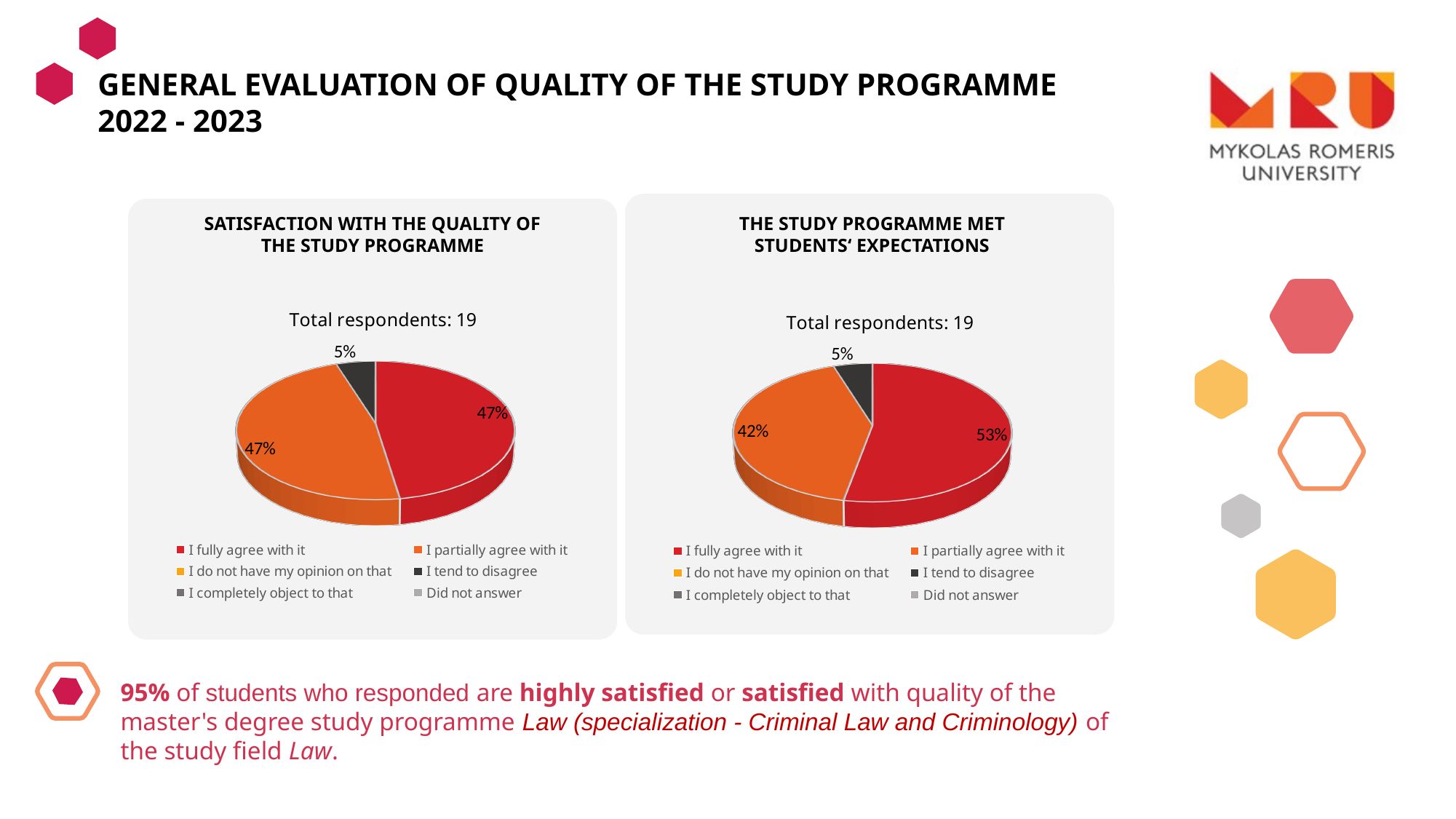
How many entries does the legend list in the chart titled 'The study programme met students' expectations'? 6 How many slices are visible in the pie in the chart titled 'Satisfaction with the quality of the study programme'? 3 In the chart titled 'The study programme met students' expectations', what share of respondents chose 'I fully agree with it'? 53% In the chart titled 'The study programme met students' expectations', which is larger: the share for 'I fully agree with it' or for 'I partially agree with it'? I fully agree with it In the chart titled 'Satisfaction with the quality of the study programme', what share of respondents chose 'I tend to disagree'? 5% In the chart titled 'The study programme met students' expectations', what share of respondents chose 'I partially agree with it'? 42% In the chart titled 'The study programme met students' expectations', which response has the largest slice? I fully agree with it In the chart titled 'Satisfaction with the quality of the study programme', what share of respondents chose 'I fully agree with it'? 47% What type of chart is used in the chart titled 'Satisfaction with the quality of the study programme'? Pie chart How many total respondents are reported for the chart titled 'The study programme met students' expectations'? 19 In the chart titled 'The study programme met students' expectations', what is the difference in percentage points between 'I fully agree with it' and 'I partially agree with it'? 11 percentage points In the chart titled 'Satisfaction with the quality of the study programme', which response has the smallest slice? I tend to disagree